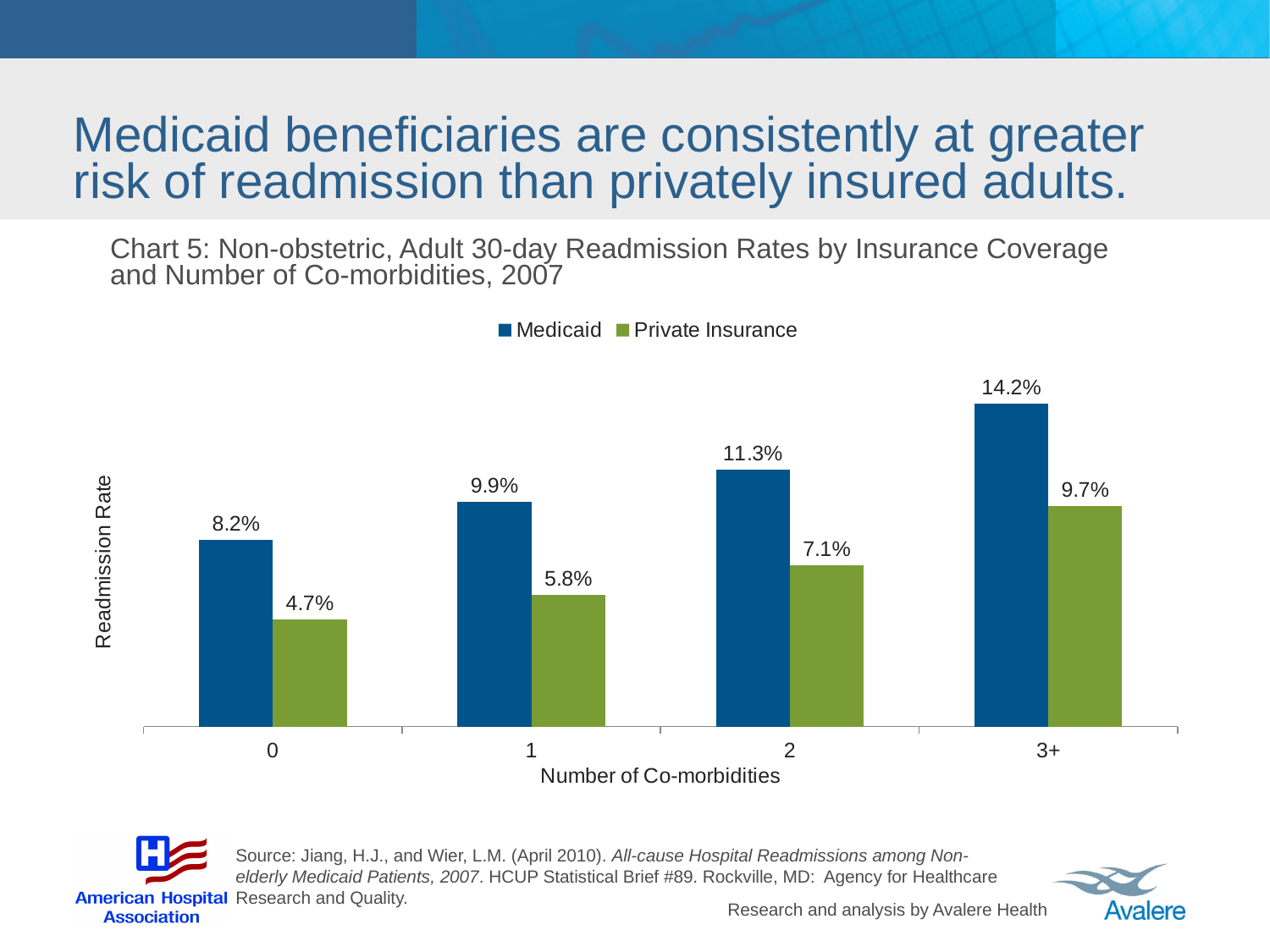
Which number of co-morbidities has the lowest Private Insurance readmission rate? 0 Do the Medicaid readmission rates rise or fall as the number of co-morbidities increases? Rise What is the Private Insurance readmission rate for patients with 3+ co-morbidities? 9.7% Which is larger: the Medicaid rate for 2 co-morbidities or the Private Insurance rate for 3+ co-morbidities? Medicaid rate for 2 co-morbidities What is the Medicaid readmission rate for patients with 0 co-morbidities? 8.2% Which number of co-morbidities has the highest Medicaid readmission rate? 3+ What is the Private Insurance readmission rate for patients with 2 co-morbidities? 7.1% What is the difference between the Medicaid and Private Insurance readmission rates for patients with 1 co-morbidity? 4.1% What is the difference between the Medicaid readmission rate for 3+ co-morbidities and for 0 co-morbidities? 6.0% What kind of chart is shown on the slide? Bar chart How many co-morbidity categories are shown on the x axis? 4 How many series does the legend list? 2